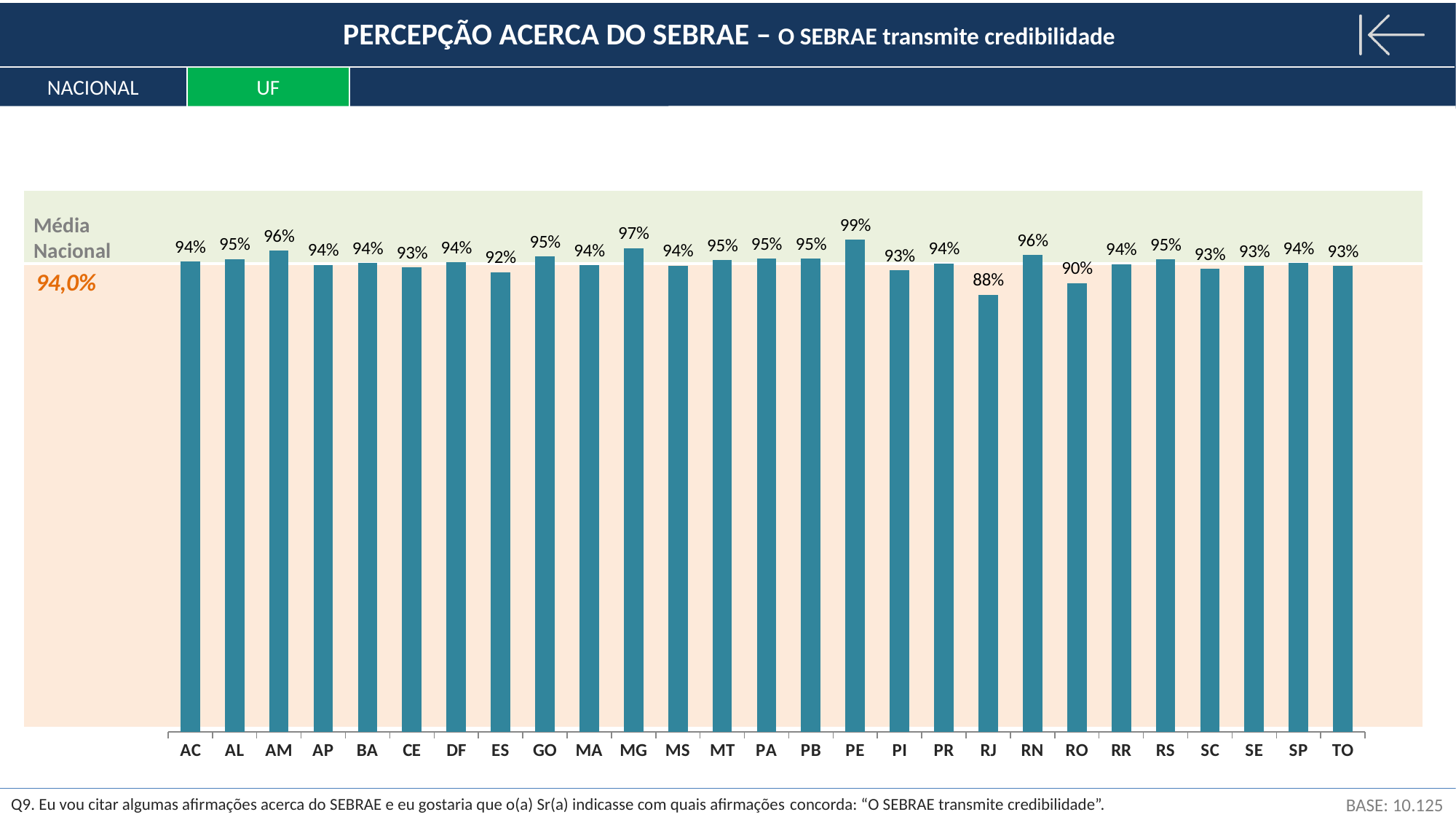
What is the value for RO? 90% What is the value for PE? 99% Which state (UF) has the highest value? PE Which state (UF) has the lowest value? RJ Which is larger, the value for AM or the value for ES? AM What is the difference between the values for MG and RO? 7% What is the Média Nacional value shown on the chart? 94,0% What is the value for MG? 97% What is the difference between the values for PE and RJ? 11% What is the value for RJ? 88% How many states (UF) are shown on the x axis? 27 What kind of chart is shown on the slide? Bar chart